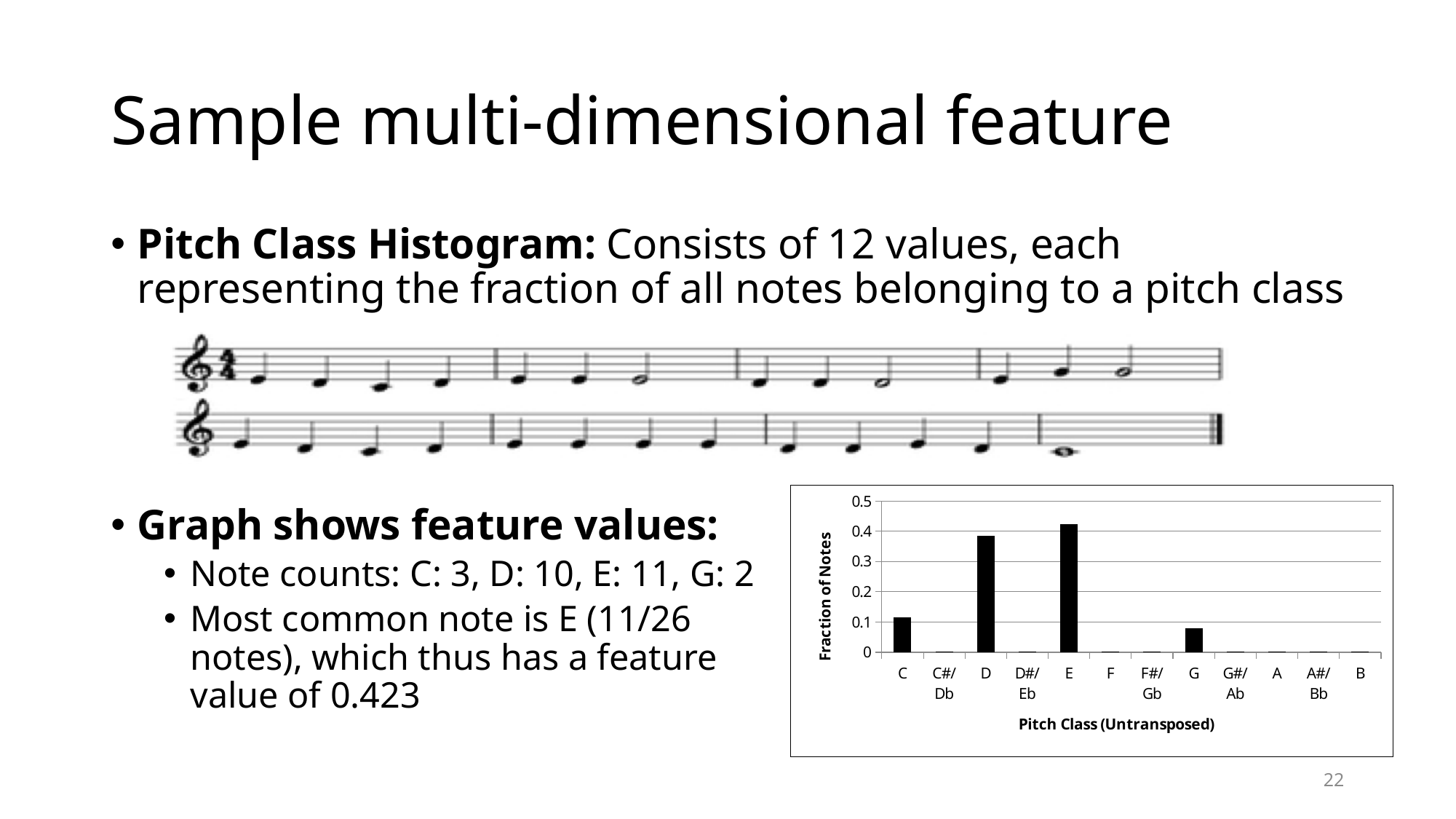
Which has a larger fraction of notes, D or E? E What is the label of the y axis of the chart? Fraction of Notes Which pitch class has the highest fraction of notes in the chart? E How many pitch classes are shown along the x axis of the chart? 12 What is the label of the x axis of the chart? Pitch Class (Untransposed) Is the value for C greater or less than 0.2? less Which has a larger fraction of notes, C or G? C What kind of chart is shown on the slide? bar chart Is the value for E greater or less than 0.3? greater Which has a larger fraction of notes, C or D? D Is the value for D greater or less than 0.3? greater